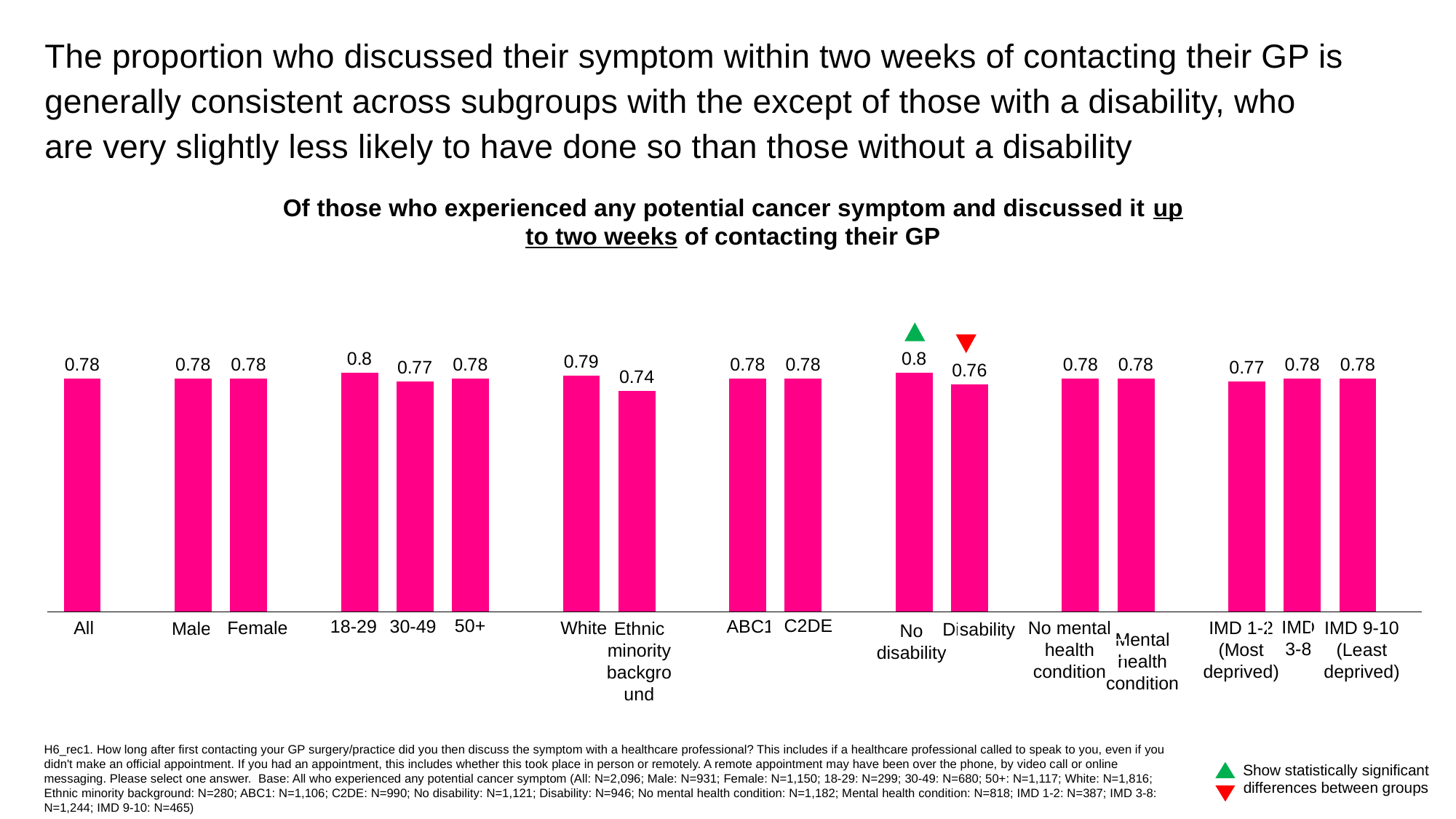
How many bars are plotted in the chart? 17 Which group is marked with a red downward triangle indicating a statistically significant difference? Disability What is the value shown for the Ethnic minority background group? 0.74 What is the difference between the values for White and Ethnic minority background? 0.05 What is the difference between the values for No disability and Disability? 0.04 Which group has the lowest value in the chart? Ethnic minority background What is the value shown for the All group? 0.78 What is the value shown for the Disability group? 0.76 What is the value shown for the 18-29 age group? 0.8 What type of chart is shown on the slide? Bar chart Which is larger, the value for White or the value for Ethnic minority background? White Which is larger, the value for 18-29 or the value for 30-49? 18-29